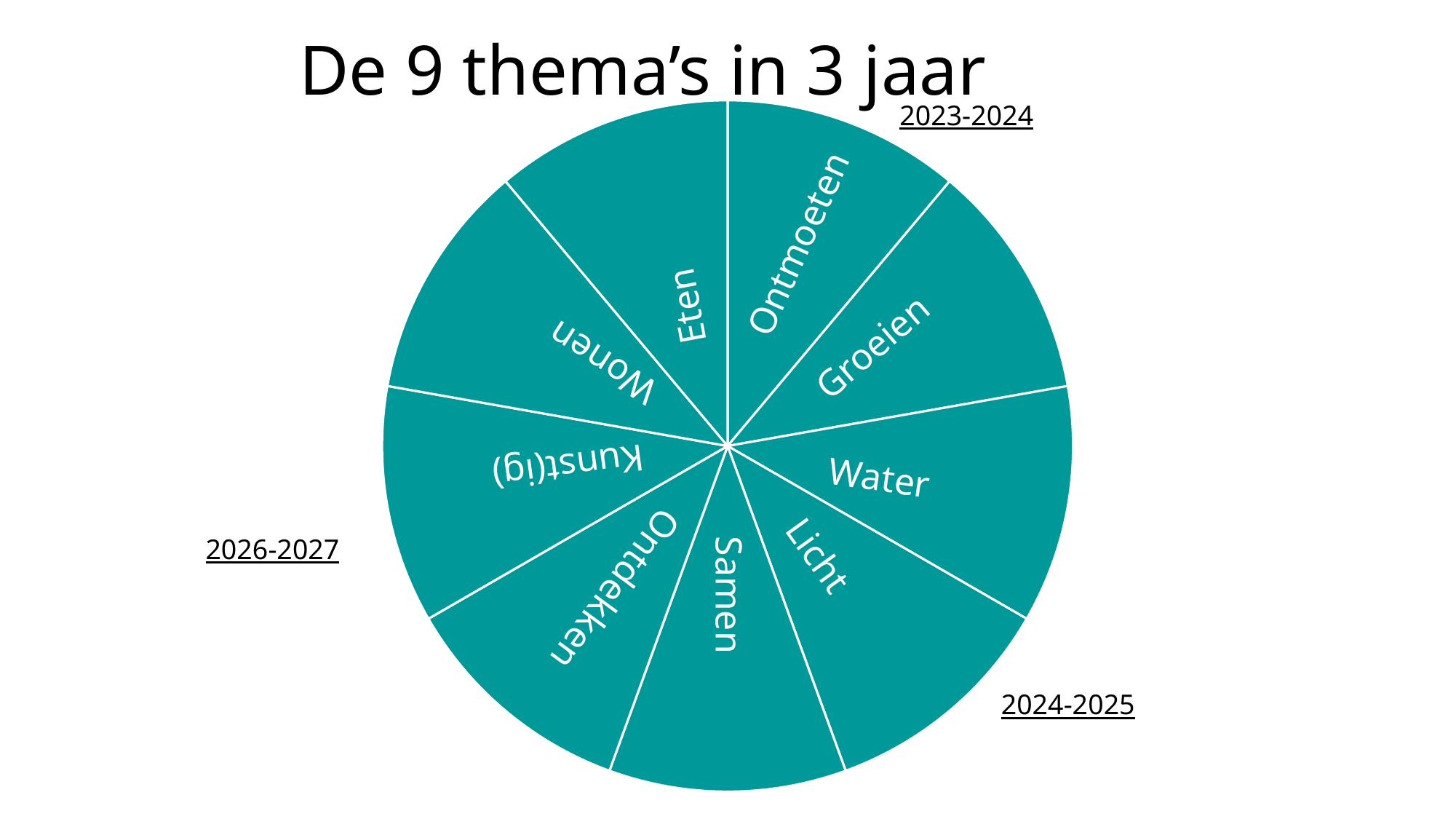
Which school year label is written to the left of the chart? 2026-2027 Which slice lies between the Water slice and the Samen slice? Licht Which slice lies between the Groeien slice and the Licht slice? Water Which school year label is written at the bottom right of the chart? 2024-2025 Which slice lies between the Samen slice and the Kunst(ig) slice? Ontdekken What is the title of the chart? De 9 thema's in 3 jaar What kind of chart is shown on the slide? pie chart Which school year label is written next to the Ontmoeten slice at the top right of the chart? 2023-2024 Which slice lies between the Eten slice and the Groeien slice? Ontmoeten Which slice lies between the Kunst(ig) slice and the Eten slice? Wonen How many slices does the pie chart have? 9 What colour are the slices of the pie chart? teal